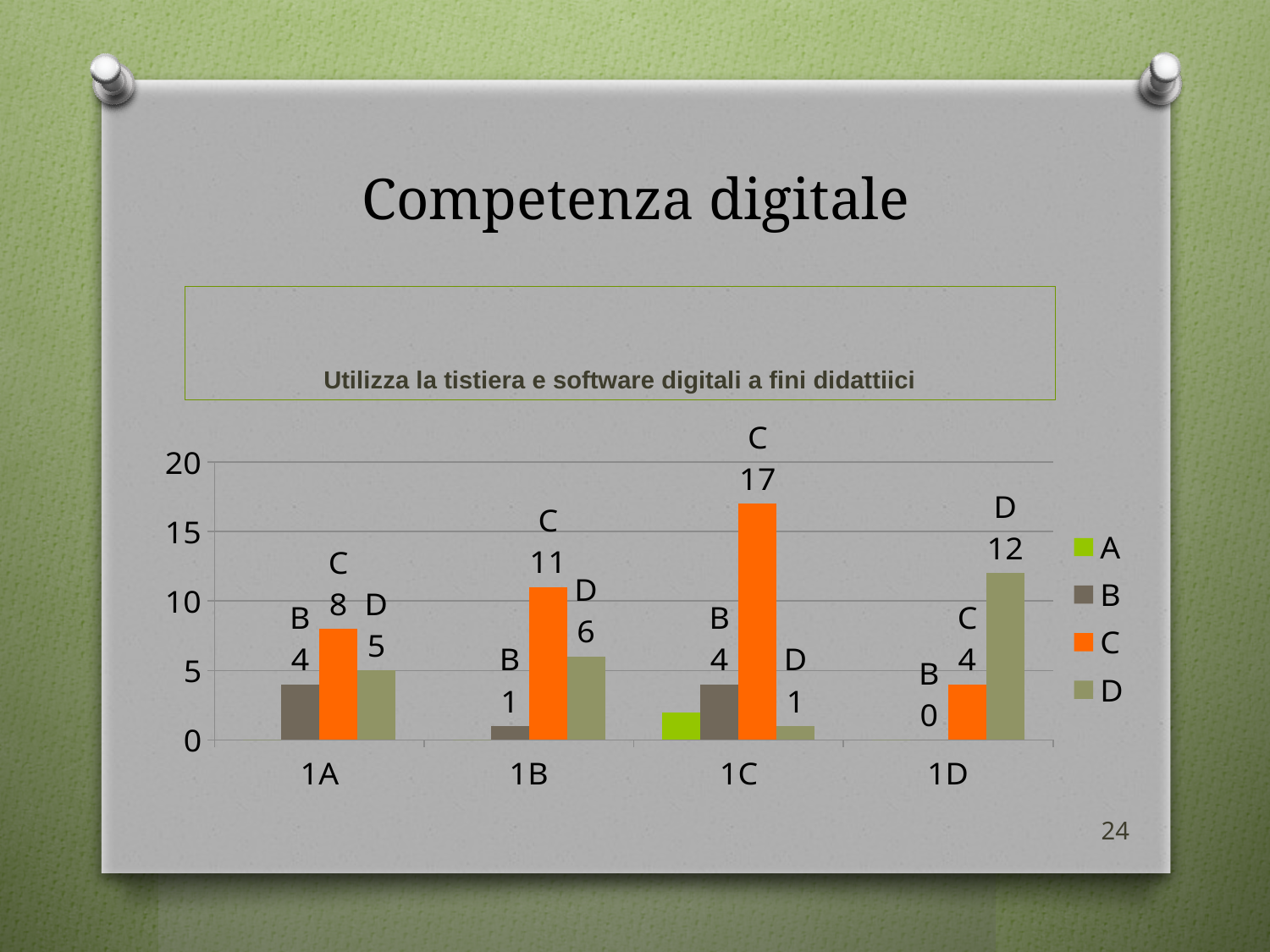
Is the value of series C for category 1B greater or less than 10? greater Which category has the lowest value for series B? 1D How many series does the legend list? 4 How many categories are shown on the x axis? 4 What is the value of series C for category 1A? 8 What is the value of series D for category 1D? 12 Which category has the highest value for series C? 1C What is the value of series C for category 1C? 17 What is the difference between the series C values for 1C and 1B? 6 What is the value of series B for category 1B? 1 What kind of chart is shown on the slide? bar chart Which is larger for category 1D: series C or series D? D